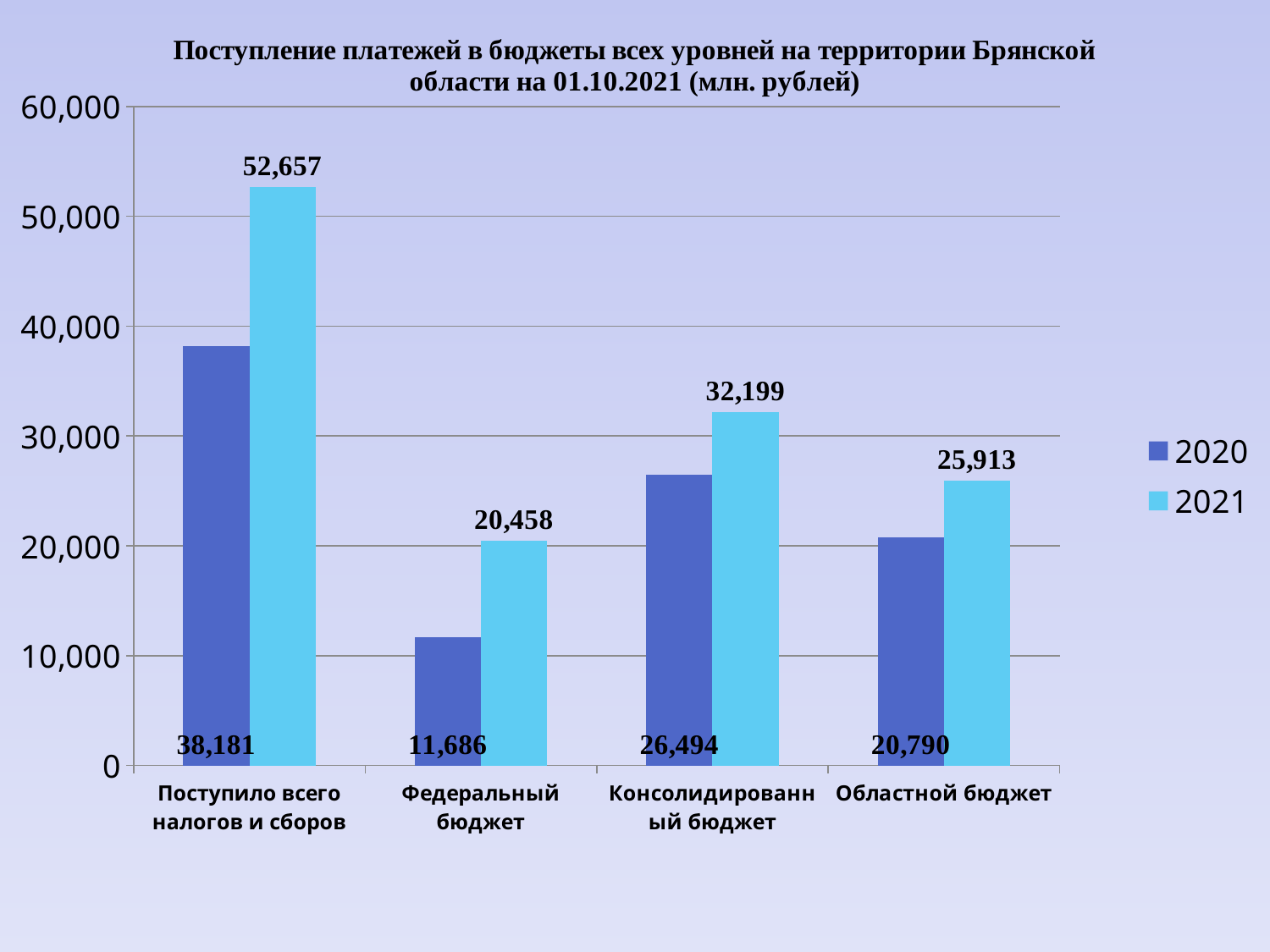
What type of chart is shown on the slide? bar chart What is the difference between the 2021 and 2020 values for Поступило всего налогов и сборов? 14,476 What is the 2020 value for Федеральный бюджет? 11,686 How many categories are shown on the x axis? 4 What is the 2021 value for Консолидированный бюджет? 32,199 What is the 2021 value for Поступило всего налогов и сборов? 52,657 Which category has the highest 2021 value? Поступило всего налогов и сборов What is the 2020 value for Областной бюджет? 20,790 How many series does the legend list? 2 Which legend entry is shown in light blue? 2021 Which category has the lowest 2020 value? Федеральный бюджет Which is larger: the 2021 value for Федеральный бюджет or the 2020 value for Областной бюджет? 2020 value for Областной бюджет